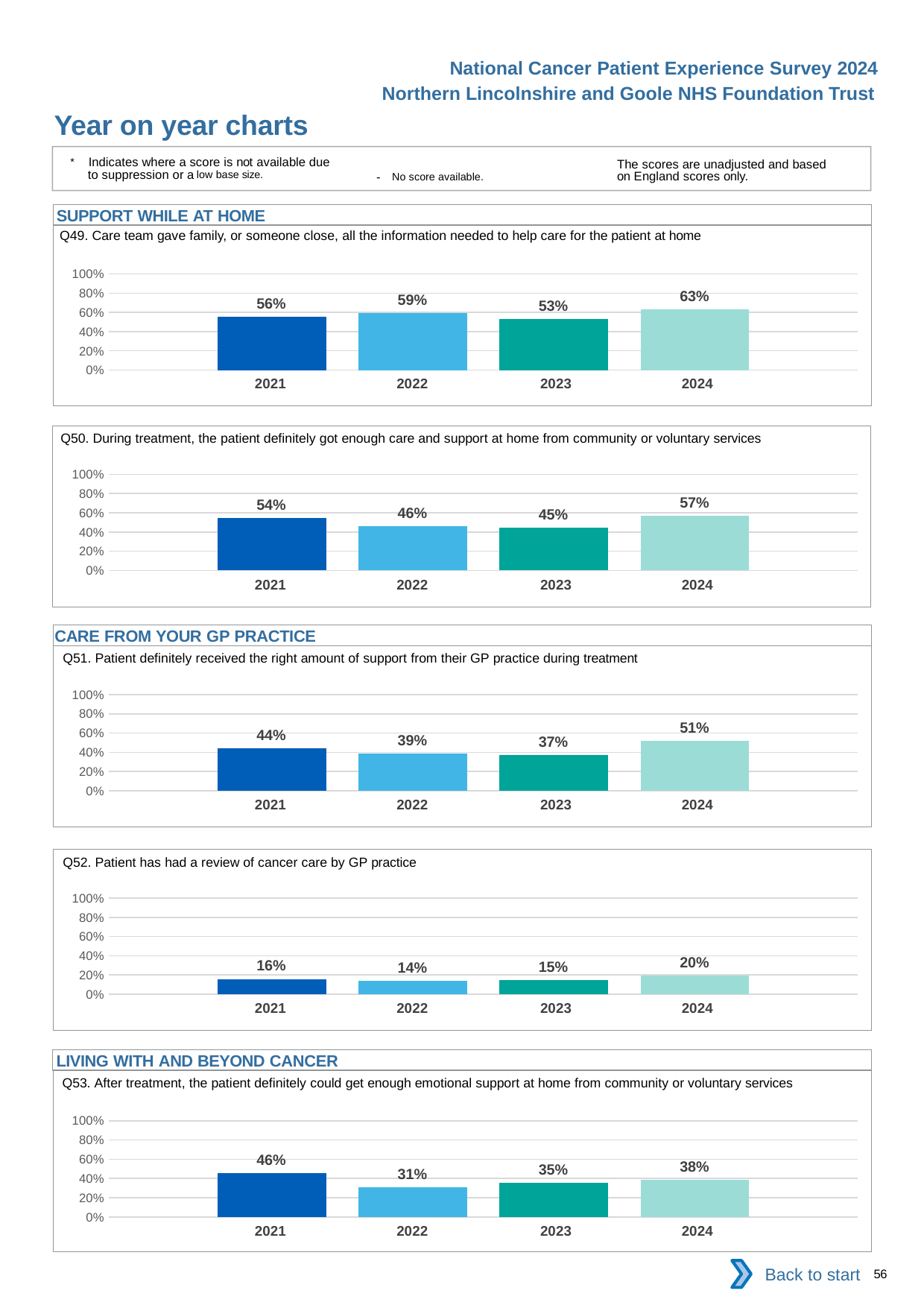
In the Q50 chart, what is the value for 2021? 54% How many bars are plotted in the Q50 chart? 4 Which section heading appears above the Q53 chart? LIVING WITH AND BEYOND CANCER In the Q53 chart, which is larger, the value for 2021 or the value for 2024? 2021 In the Q49 chart, what is the value for 2024? 63% In the Q51 chart, what is the difference between the 2024 and 2023 values? 14% In the Q49 chart, what is the difference between the 2022 and 2021 values? 3% In the Q53 chart, what is the value for 2022? 31% In the Q51 chart, is the value for 2024 greater or less than 40%? greater In the Q52 chart, which year has the highest value? 2024 In the Q50 chart, which year has the lowest value? 2023 What kind of chart is the Q52 chart? Bar chart